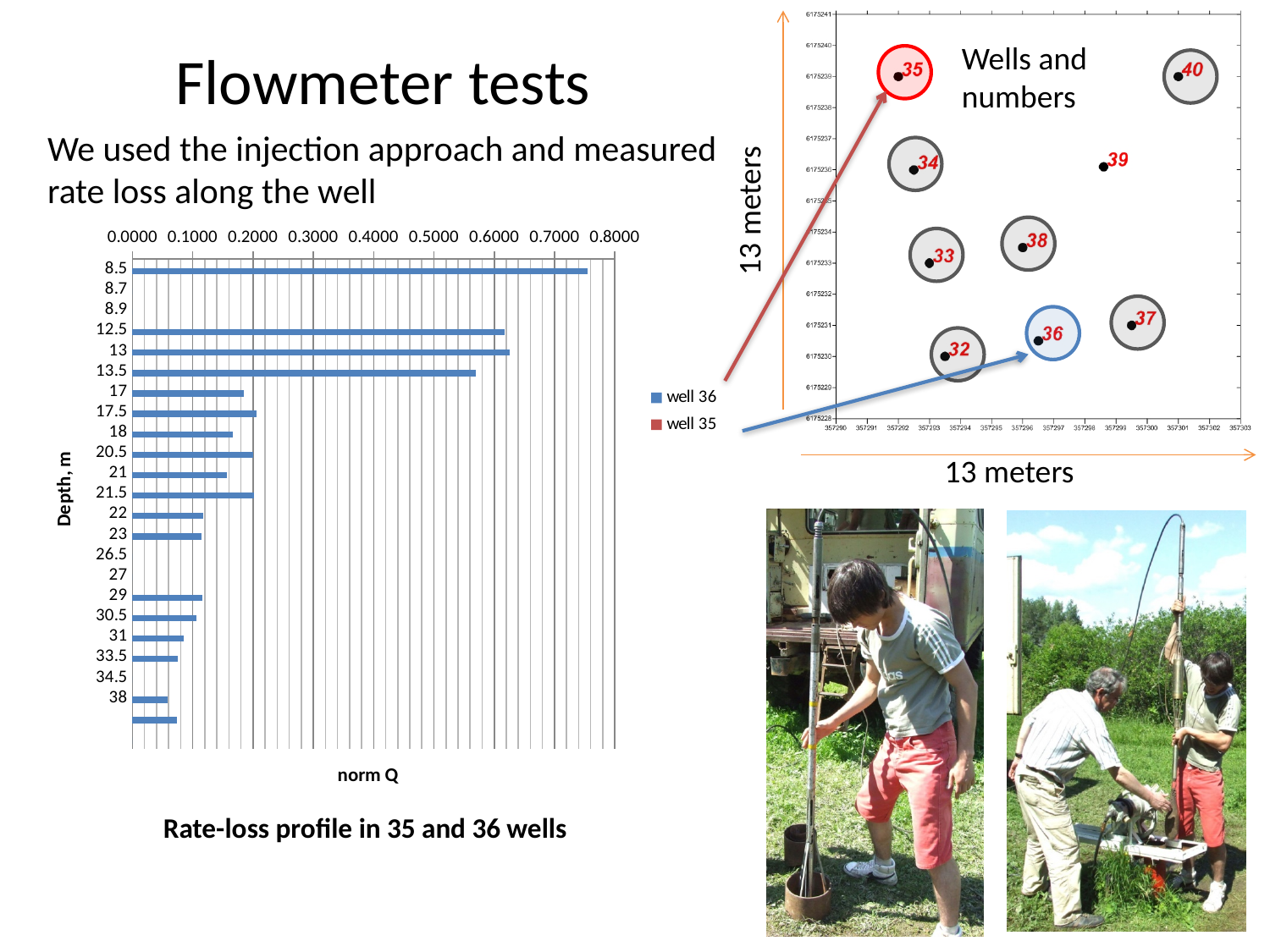
Is the norm Q value for depth 22 greater or less than 0.1000? greater Is the norm Q value for depth 38 greater or less than 0.1000? less What is the label of the horizontal axis of the bar chart? norm Q Is the norm Q value for depth 17 greater or less than 0.2000? less How many series does the legend of the bar chart list? 2 What kind of chart is shown on the left of the slide? bar chart Which depth has the highest norm Q value in the bar chart? 8.5 Which series in the bar chart legend is shown in blue? well 36 Which depth has the larger norm Q value, 13 or 13.5? 13 Which depth has the larger norm Q value, 8.5 or 17? 8.5